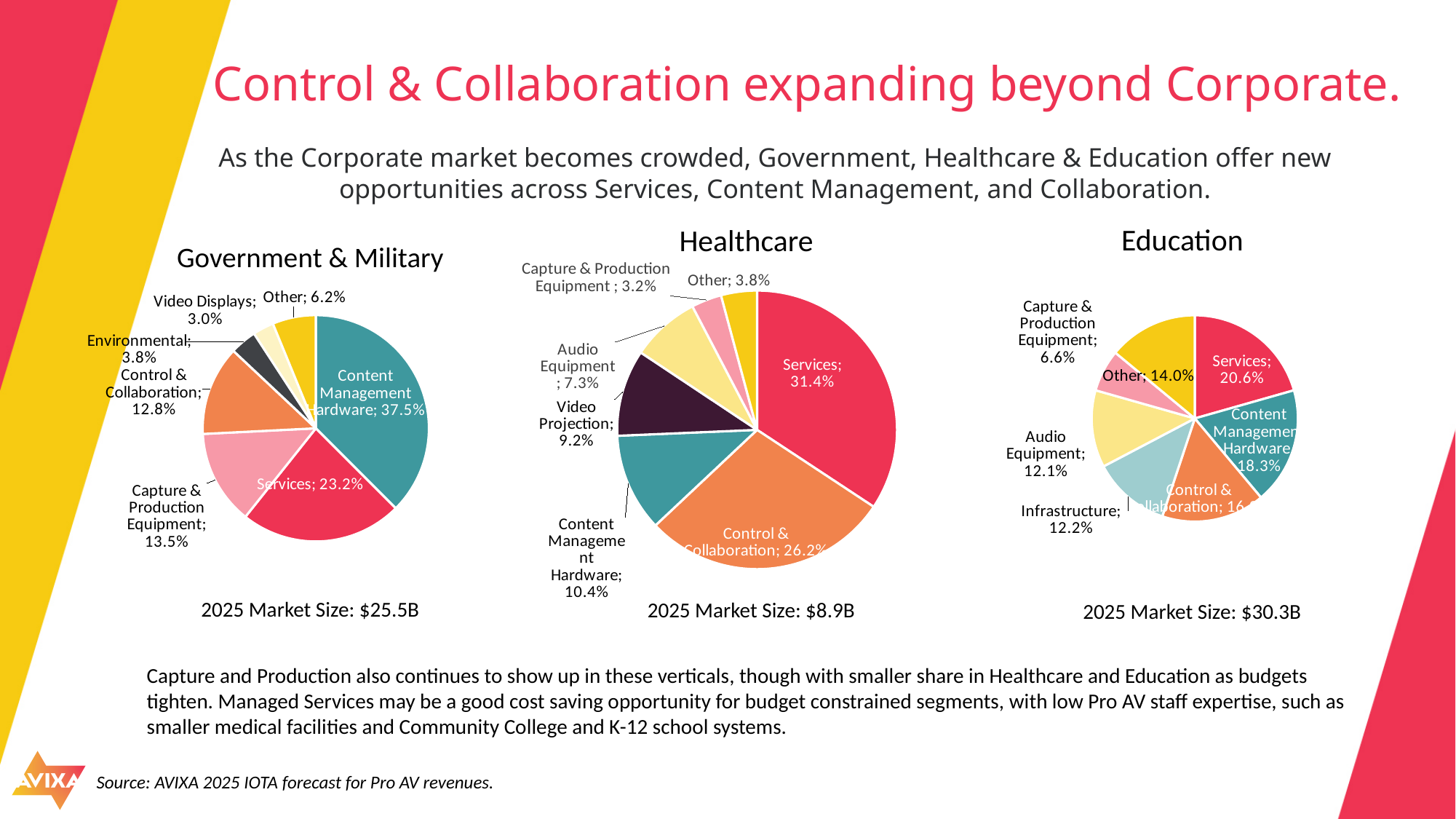
In the Government & Military pie chart, which category has the smallest share? Video Displays Which has a larger share of Audio Equipment: the Healthcare pie chart or the Education pie chart? Education In the Education pie chart, which category has the smallest share? Capture & Production Equipment In the Education pie chart, which category has the largest share? Services In the Government & Military pie chart, which category has the largest share? Content Management Hardware What is the 2025 market size shown under the Healthcare pie chart? $8.9B In the Education pie chart, what share does Capture & Production Equipment have? 6.6% What type of chart is used for the Healthcare market breakdown? Pie chart How many slices does the Government & Military pie chart have? 7 In the Healthcare pie chart, what share does Services have? 31.4% In the Government & Military pie chart, what share does Content Management Hardware have? 37.5% In the Healthcare pie chart, what is the difference in percentage points between Services and Control & Collaboration? 5.2 percentage points